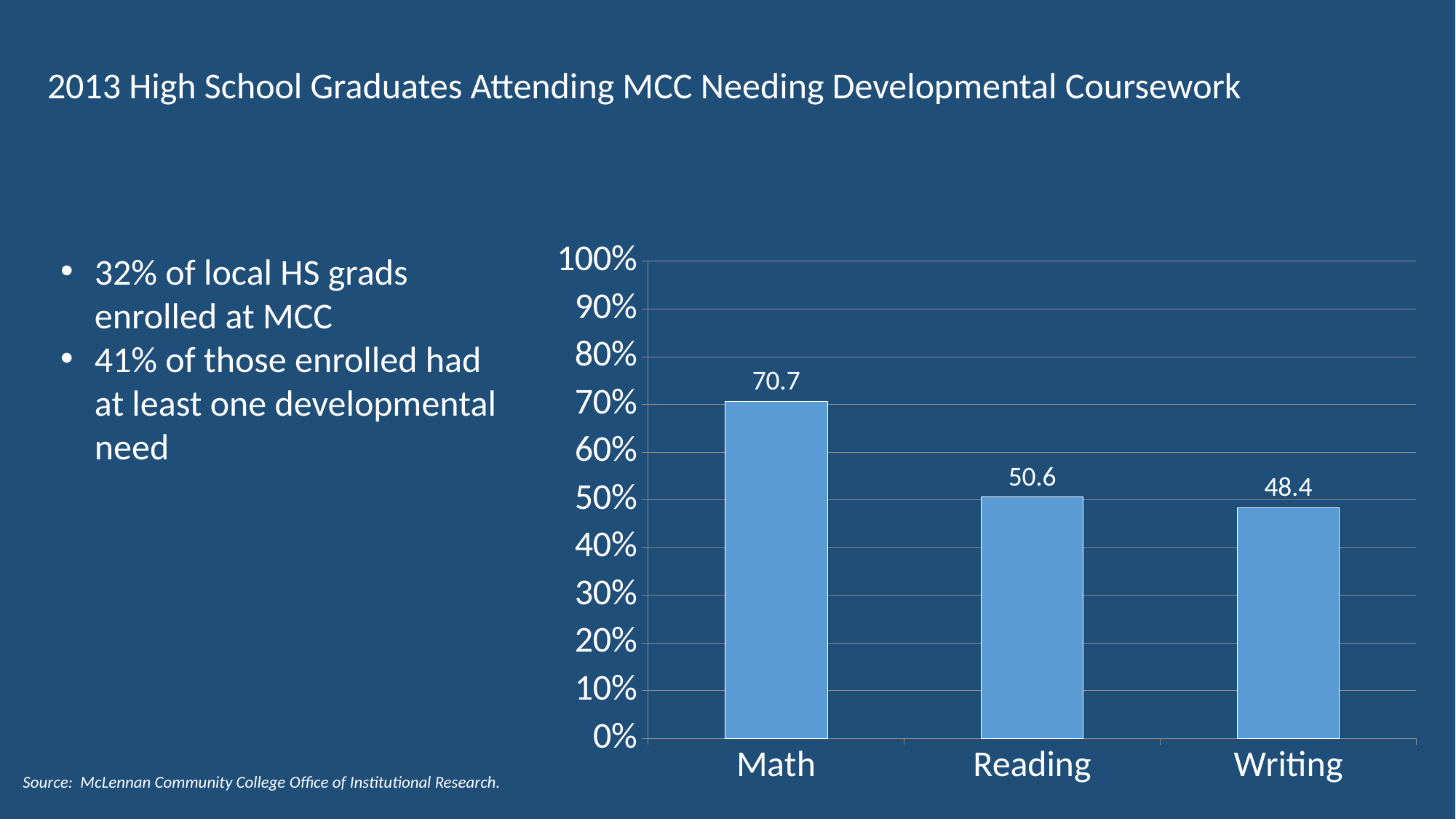
What is the value for Writing? 48.4 What is the difference between the values for Math and Reading? 20.1 What is the difference between the values for Reading and Writing? 2.2 What is the value for Reading? 50.6 Is the value for Writing greater or less than 50%? less What is the value for Math? 70.7 Which category has the lowest value? Writing Do the values rise or fall from Math to Writing along the x axis? fall What kind of chart is shown on the slide? bar chart Which is larger, the value for Math or the value for Writing? Math How many categories are shown on the x axis? 3 Which category has the highest value? Math